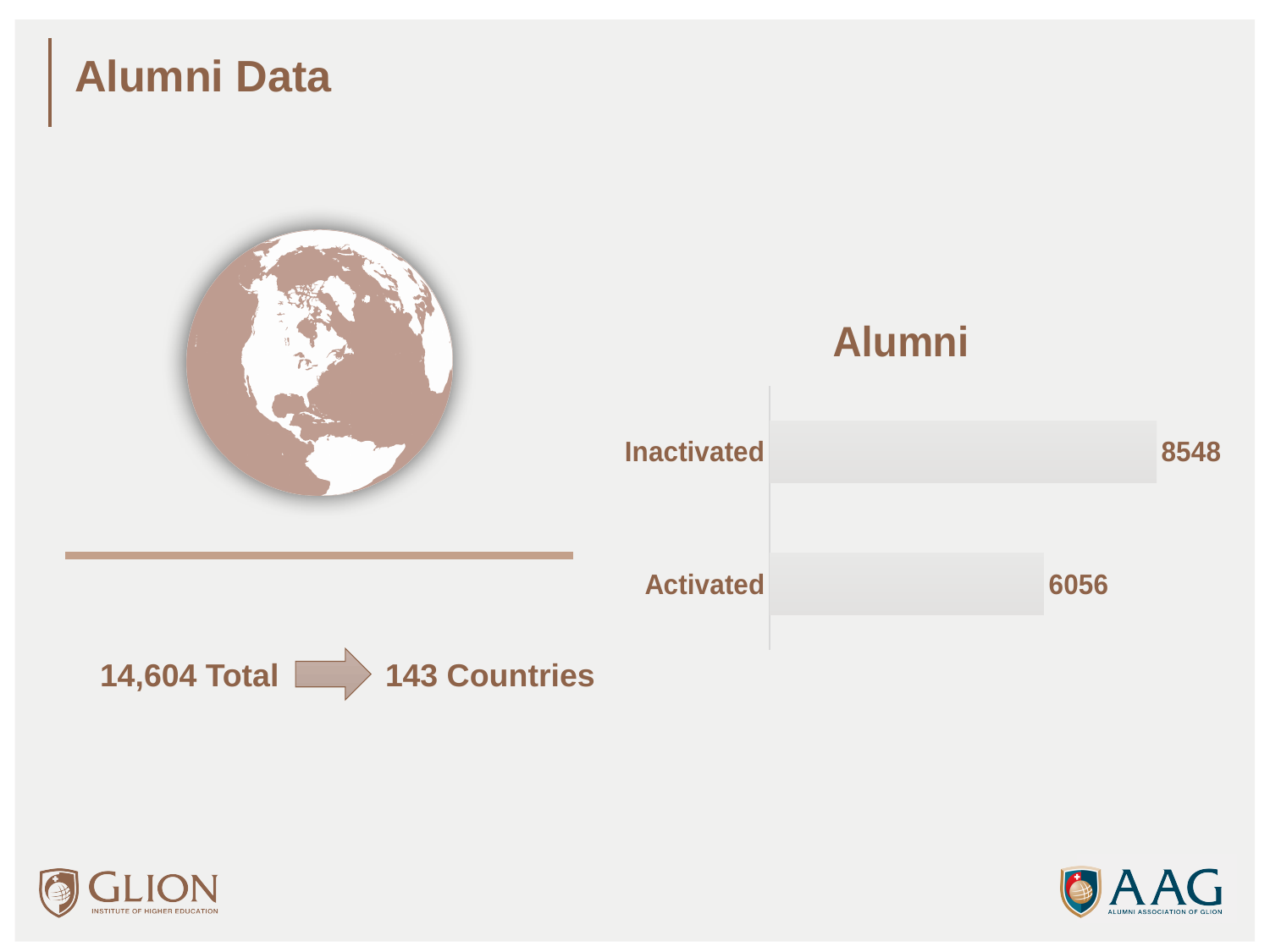
What is the value for Activated alumni? 6056 Which is larger, the value for Activated or for Inactivated? Inactivated What is the difference between the Inactivated and Activated values? 2492 How many categories are shown in the chart? 2 What is the title of the chart? Alumni What kind of chart is shown on the slide? Bar chart What is the value for Inactivated alumni? 8548 Which category has the lowest value? Activated Which category has the highest value? Inactivated Are the bars in the chart horizontal or vertical? Horizontal